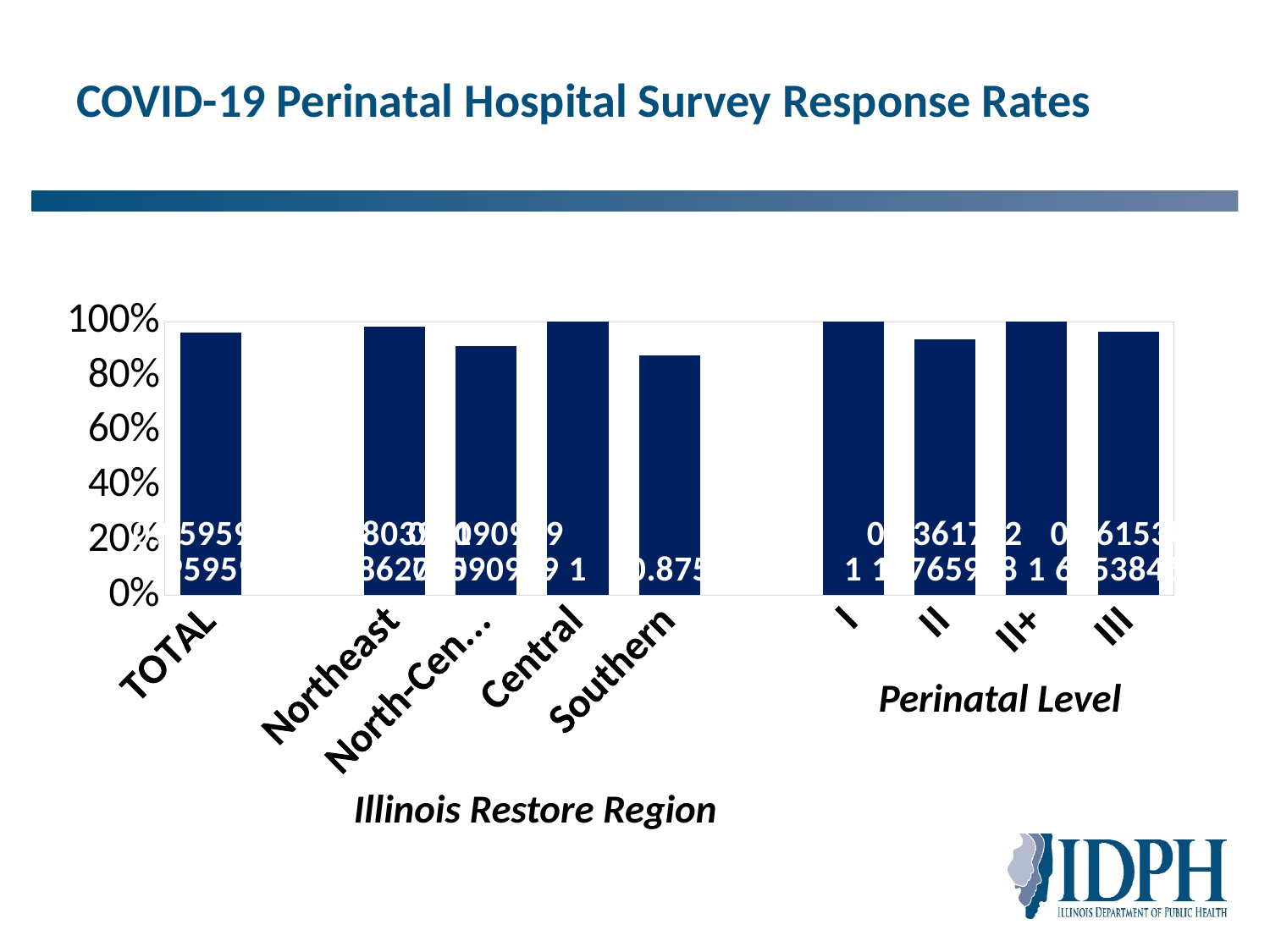
Is the value for North-Central greater or less than 80%? greater How many bars are plotted in the chart? 9 Is the value for TOTAL greater or less than 60%? greater Which is larger, the value for Northeast or the value for Southern? Northeast What is the title of the chart? COVID-19 Perinatal Hospital Survey Response Rates What kind of chart is shown on the slide? bar chart Which is larger, the value for II+ or the value for II? II+ Is the value for II greater or less than 80%? greater Which is larger, the value for Central or the value for Southern? Central What are the two group labels shown beneath the x axis? Illinois Restore Region and Perinatal Level